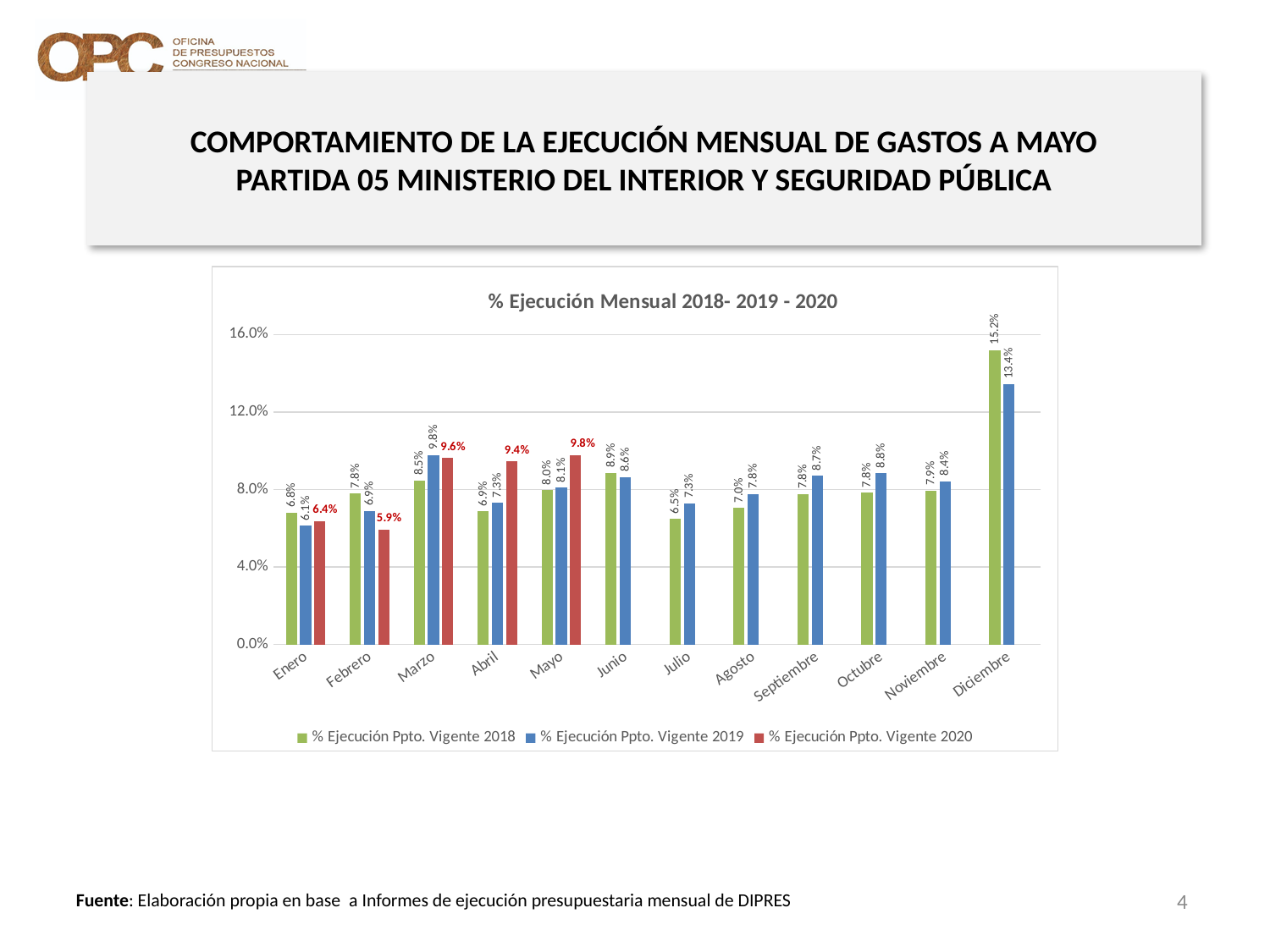
How many series does the legend list? 3 What is the value for % Ejecución Ppto. Vigente 2018 in Diciembre? 15.2% What kind of chart is shown on the slide? Bar chart Which month has the highest value for % Ejecución Ppto. Vigente 2019? Diciembre How many months are shown on the x axis? 12 Is the value for % Ejecución Ppto. Vigente 2018 in Julio greater or less than 8.0%? less What is the value for % Ejecución Ppto. Vigente 2019 in Febrero? 6.9% Which is larger in Abril: the 2019 value or the 2020 value? 2020 value (9.4%) What is the title of the chart? % Ejecución Mensual 2018- 2019 - 2020 Which month has the lowest value for % Ejecución Ppto. Vigente 2020? Febrero What is the value for % Ejecución Ppto. Vigente 2020 in Mayo? 9.8% What is the difference between the 2018 and 2019 values in Diciembre? 1.8%